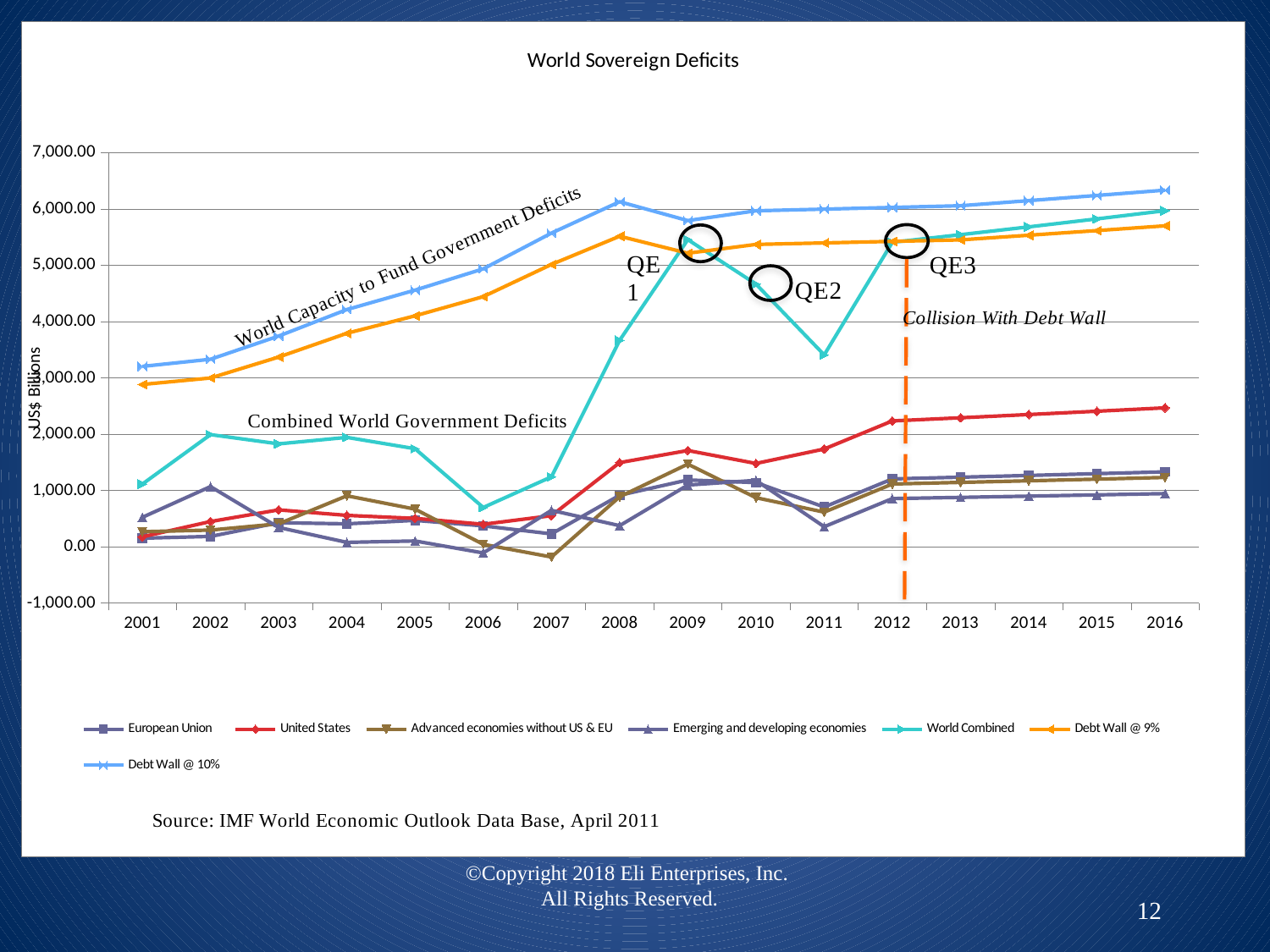
Is the value for Advanced economies without US & EU in 2007 greater or less than 0.00? less Is the value for Debt Wall @ 9% in 2001 greater or less than 3,000.00? less How many years are plotted along the x axis? 16 Is the value for World Combined in 2008 greater or less than 3,000.00? greater Does the Debt Wall @ 10% series rise or fall from 2001 to 2016? rise What is the label on the vertical axis? US$ Billions How many series does the legend list? 7 What is the title of the chart? World Sovereign Deficits What kind of chart is shown on the slide? line chart Which series has the highest value in 2016? Debt Wall @ 10% In 2008, which is larger: Debt Wall @ 10% or Debt Wall @ 9%? Debt Wall @ 10%